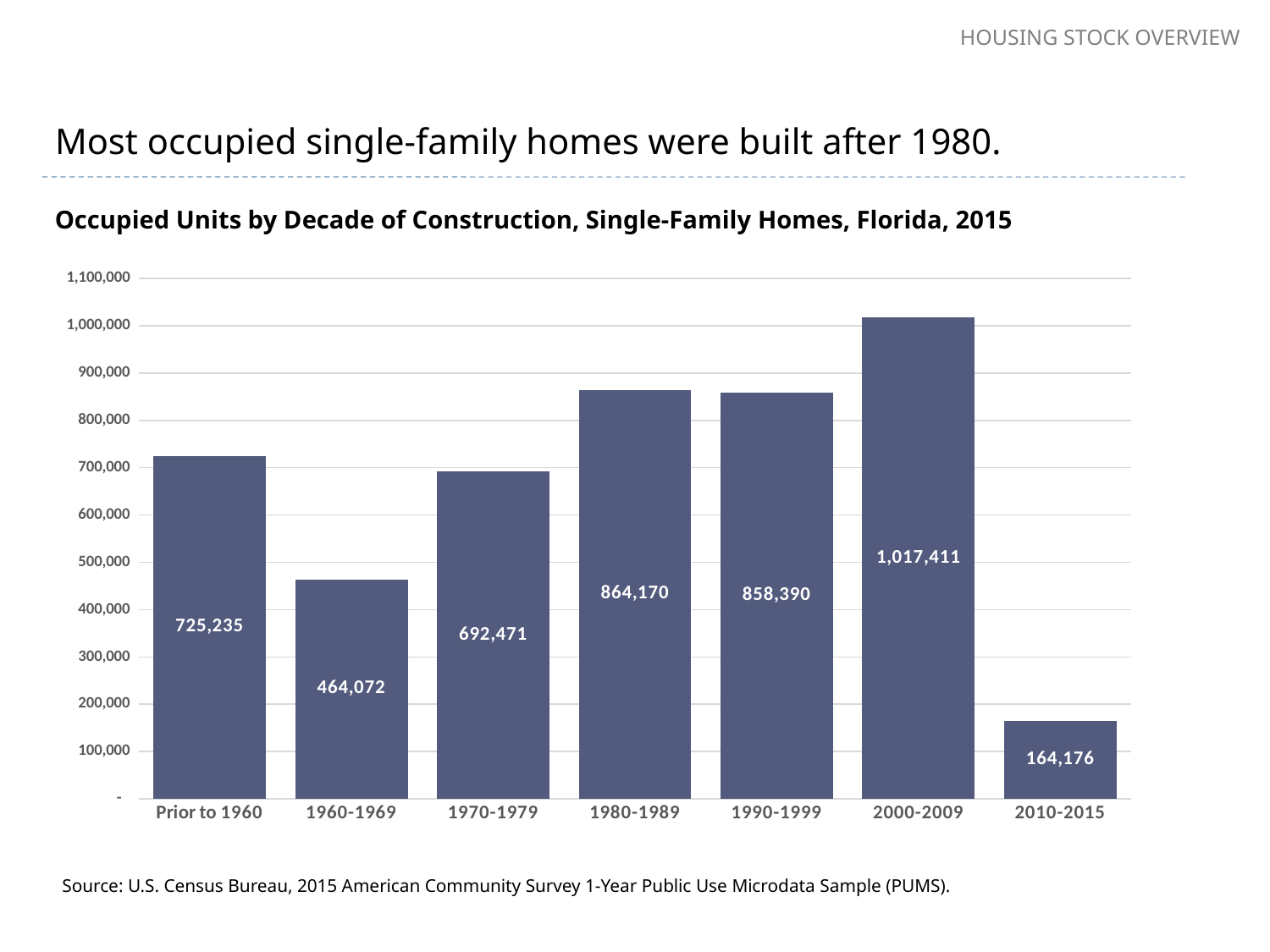
Which has more occupied units: Prior to 1960 or 1970-1979? Prior to 1960 How many occupied single-family units were built prior to 1960? 725,235 What is the title of the chart? Occupied Units by Decade of Construction, Single-Family Homes, Florida, 2015 Which decade of construction has the highest number of occupied units? 2000-2009 How many decade categories are shown on the x axis? 7 What is the difference between the values for 1980-1989 and 1990-1999? 5,780 Which decade of construction has the lowest number of occupied units? 2010-2015 What kind of chart is shown on the slide? Bar chart What is the value shown for the 1960-1969 decade? 464,072 What is the number of occupied single-family units built in 2000-2009? 1,017,411 What is the difference between the values for 2000-2009 and 2010-2015? 853,235 Is the value for 1960-1969 greater or less than 500,000? less